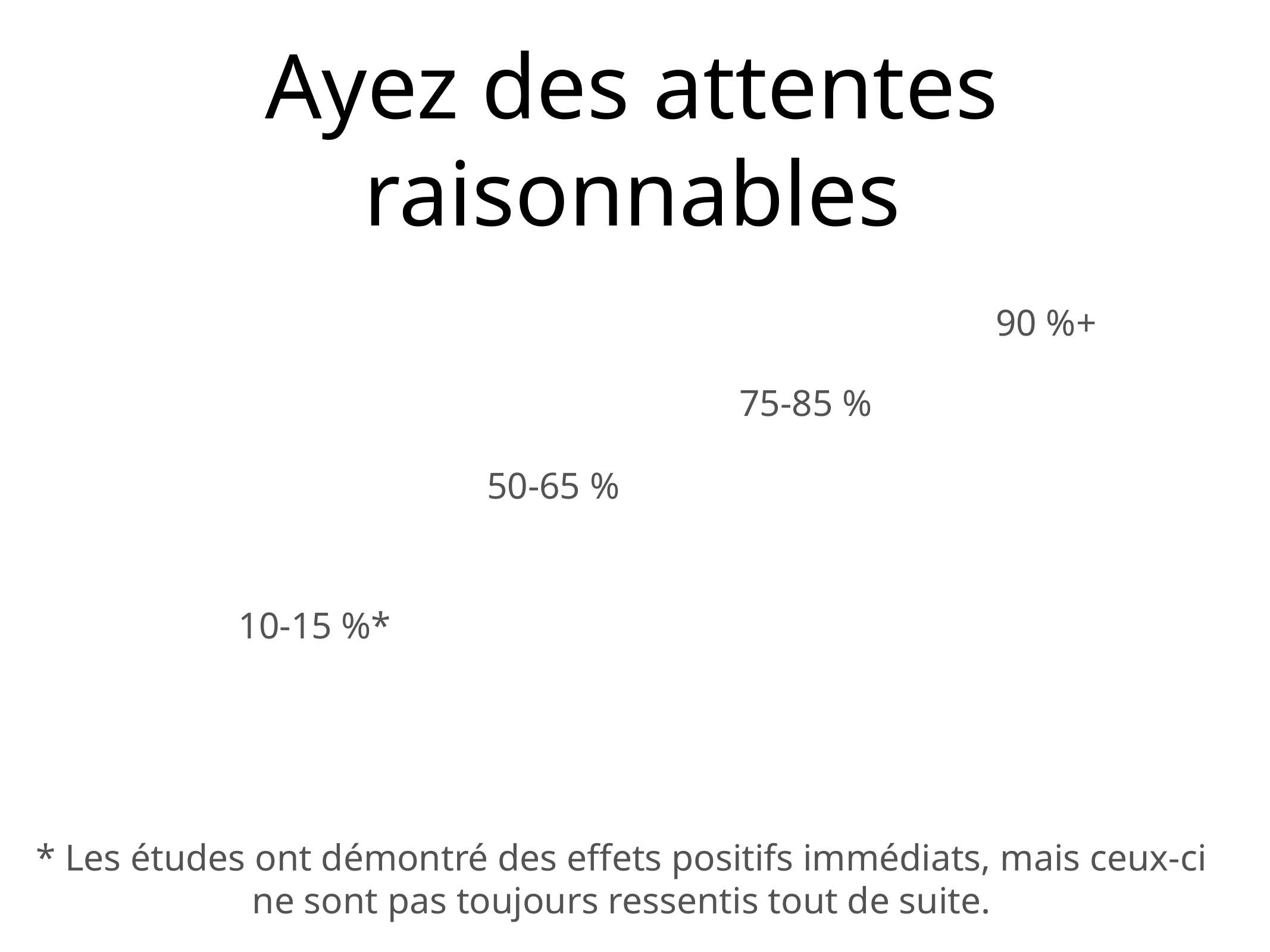
What is the highest percentage value shown on the slide? 90 %+ What is the second-lowest percentage value shown on the slide? 50-65 % What is the title of the slide? Ayez des attentes raisonnables How many percentage values are shown on the slide? 4 Which value is larger, the leftmost one or the rightmost one? the rightmost (90 %+) Which percentage value is marked with an asterisk? 10-15 %* Do the percentage values rise or fall from left to right across the slide? rise What is the lowest percentage value shown on the slide? 10-15 %*